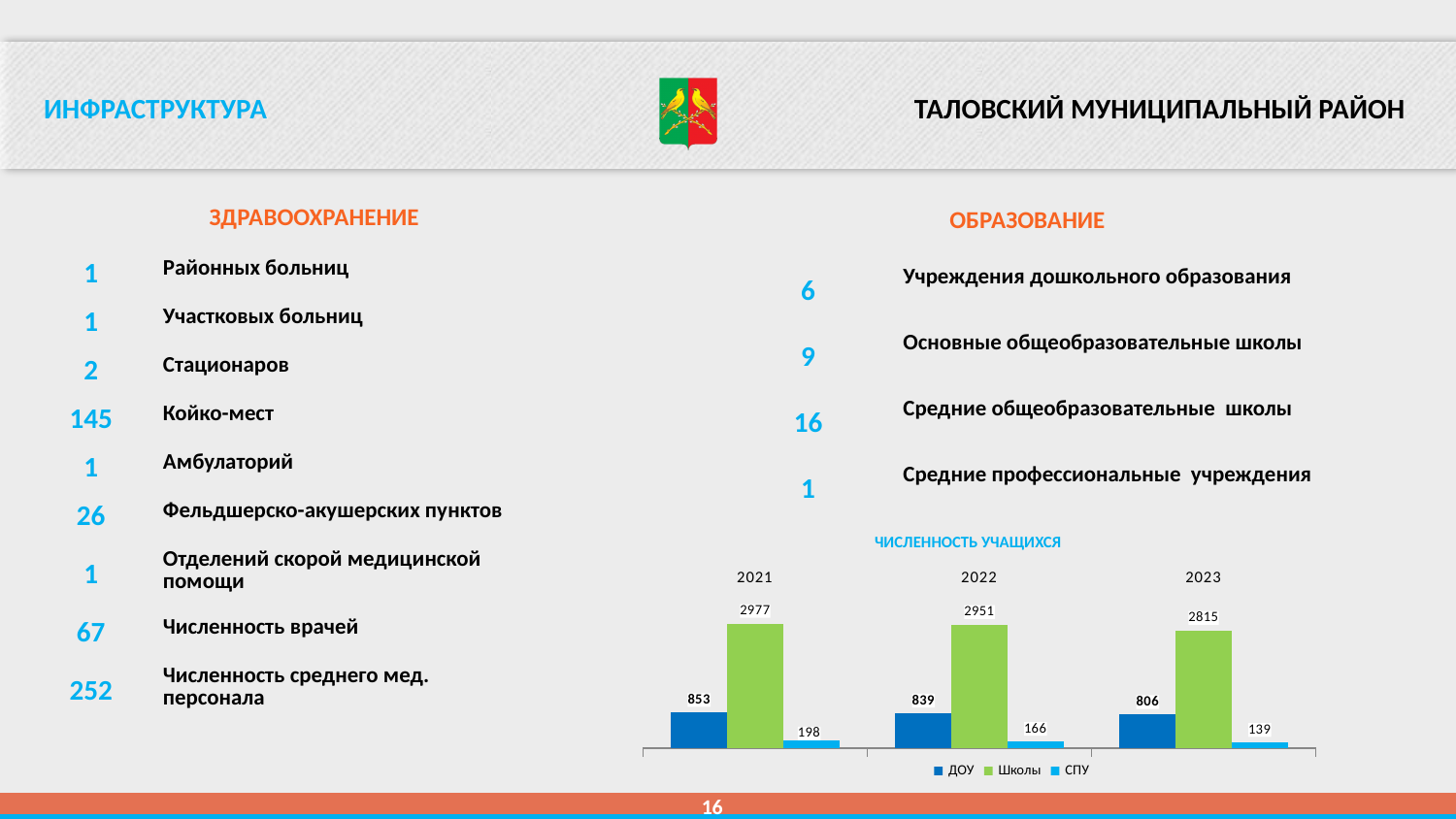
How many years are shown on the x axis of the chart? 3 What is the difference between the Школы values for 2021 and 2023? 162 What is the value for Школы in 2021? 2977 How many series does the legend list? 3 Do the values for Школы rise or fall from 2021 to 2023? fall In which year is the value for СПУ the lowest? 2023 Which is larger: the ДОУ value in 2022 or the СПУ value in 2022? ДОУ In which year is the value for Школы the highest? 2021 What is the difference between the ДОУ values for 2021 and 2022? 14 What is the value for ДОУ in 2023? 806 What is the value for СПУ in 2022? 166 What kind of chart is shown under ЧИСЛЕННОСТЬ УЧАЩИХСЯ? bar chart